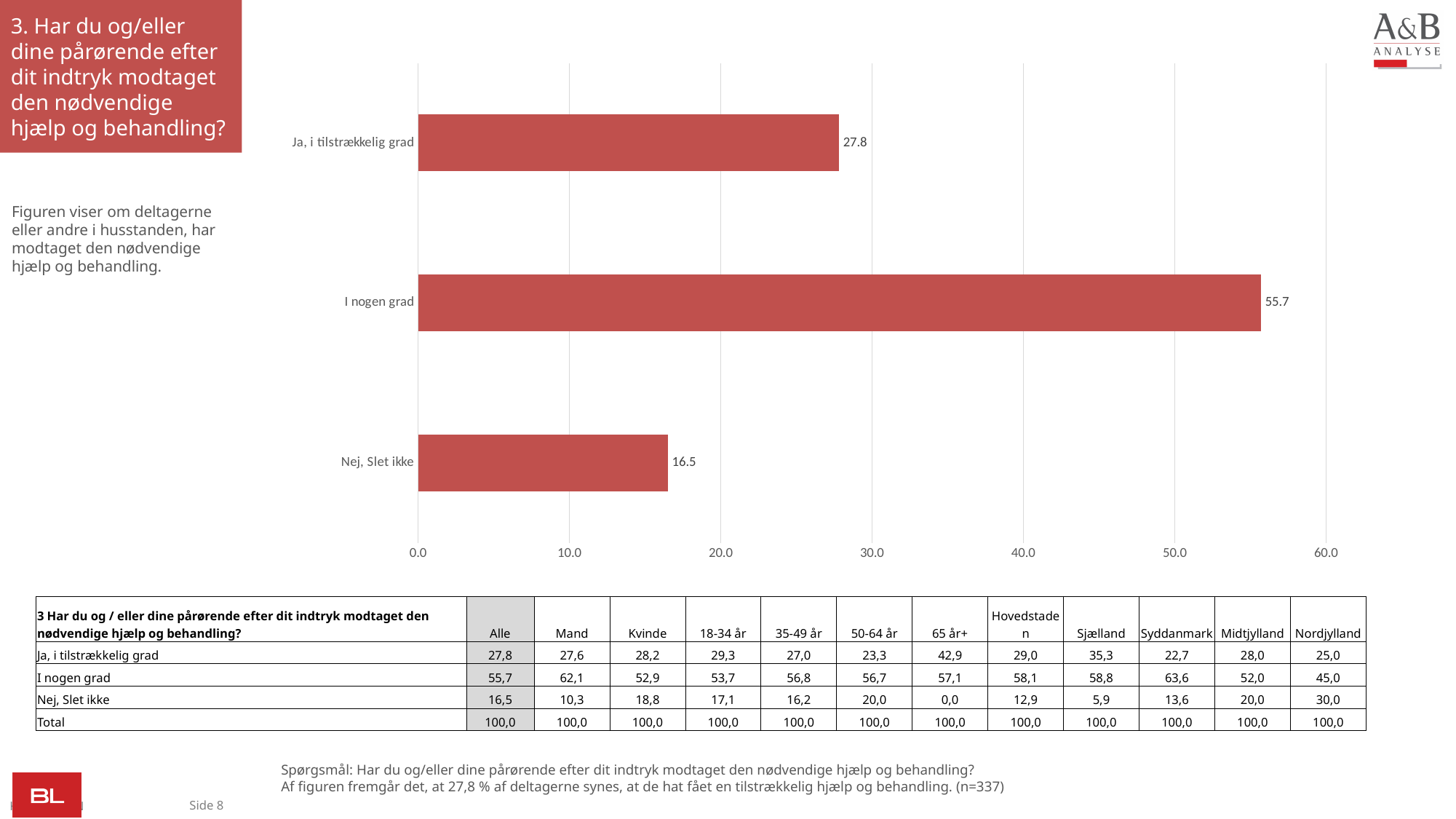
What is the difference between the values for "Ja, i tilstrækkelig grad" and "Nej, Slet ikke"? 11.3 Which category has the highest value in the bar chart? I nogen grad What is the value for "I nogen grad" in the bar chart? 55.7 What kind of chart is shown on the slide? bar chart Which is larger: the value for "Ja, i tilstrækkelig grad" or the value for "Nej, Slet ikke"? Ja, i tilstrækkelig grad How many categories are shown in the bar chart? 3 What is the difference between the values for "I nogen grad" and "Ja, i tilstrækkelig grad"? 27.9 Is the value for "I nogen grad" greater or less than 50.0? greater What is the value for "Nej, Slet ikke" in the bar chart? 16.5 Which category has the lowest value in the bar chart? Nej, Slet ikke What is the value for "Ja, i tilstrækkelig grad" in the bar chart? 27.8 What is the maximum value shown on the x axis of the bar chart? 60.0